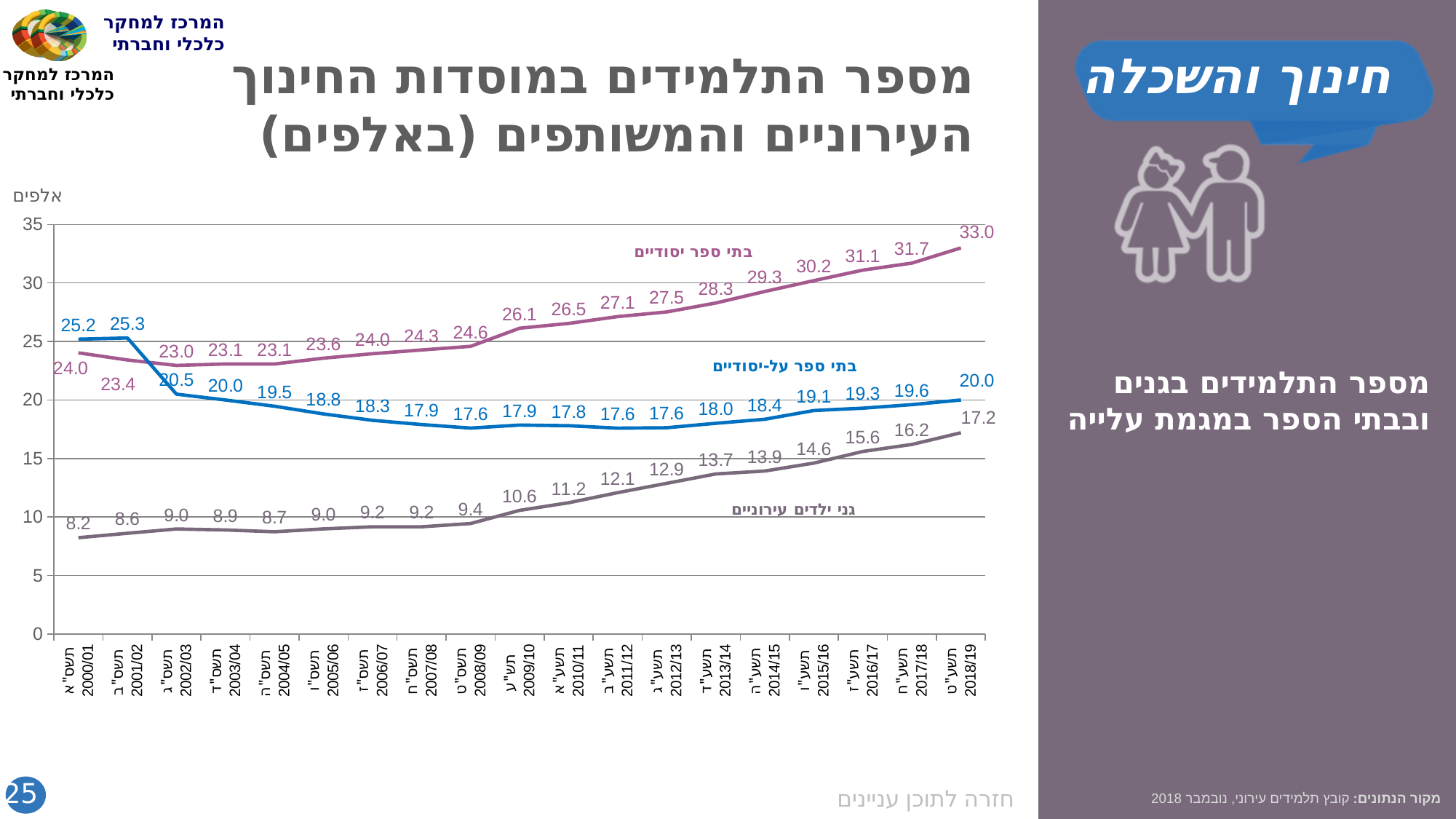
What is the value for גני ילדים עירוניים (municipal kindergartens) in 2000/01? 8.2 What is the difference between the בתי ספר יסודיים value in 2018/19 and in 2000/01? 9.0 What is the value for בתי ספר יסודיים (elementary schools) in 2018/19? 33.0 What type of chart is shown on the slide? line chart Does the גני ילדים עירוניים series rise or fall between 2008/09 and 2018/19? rise What unit label is shown above the y axis of the chart? אלפים In which school year does the גני ילדים עירוניים (municipal kindergartens) series have its lowest value? 2000/01 What is the value for בתי ספר על-יסודיים (secondary schools) in 2012/13? 17.6 In which school year does the בתי ספר על-יסודיים (secondary schools) series reach its highest value? 2001/02 In 2000/01, which series has the larger value: בתי ספר יסודיים or בתי ספר על-יסודיים? בתי ספר על-יסודיים How many data series are plotted in the chart? 3 How many school years are shown along the x axis? 19